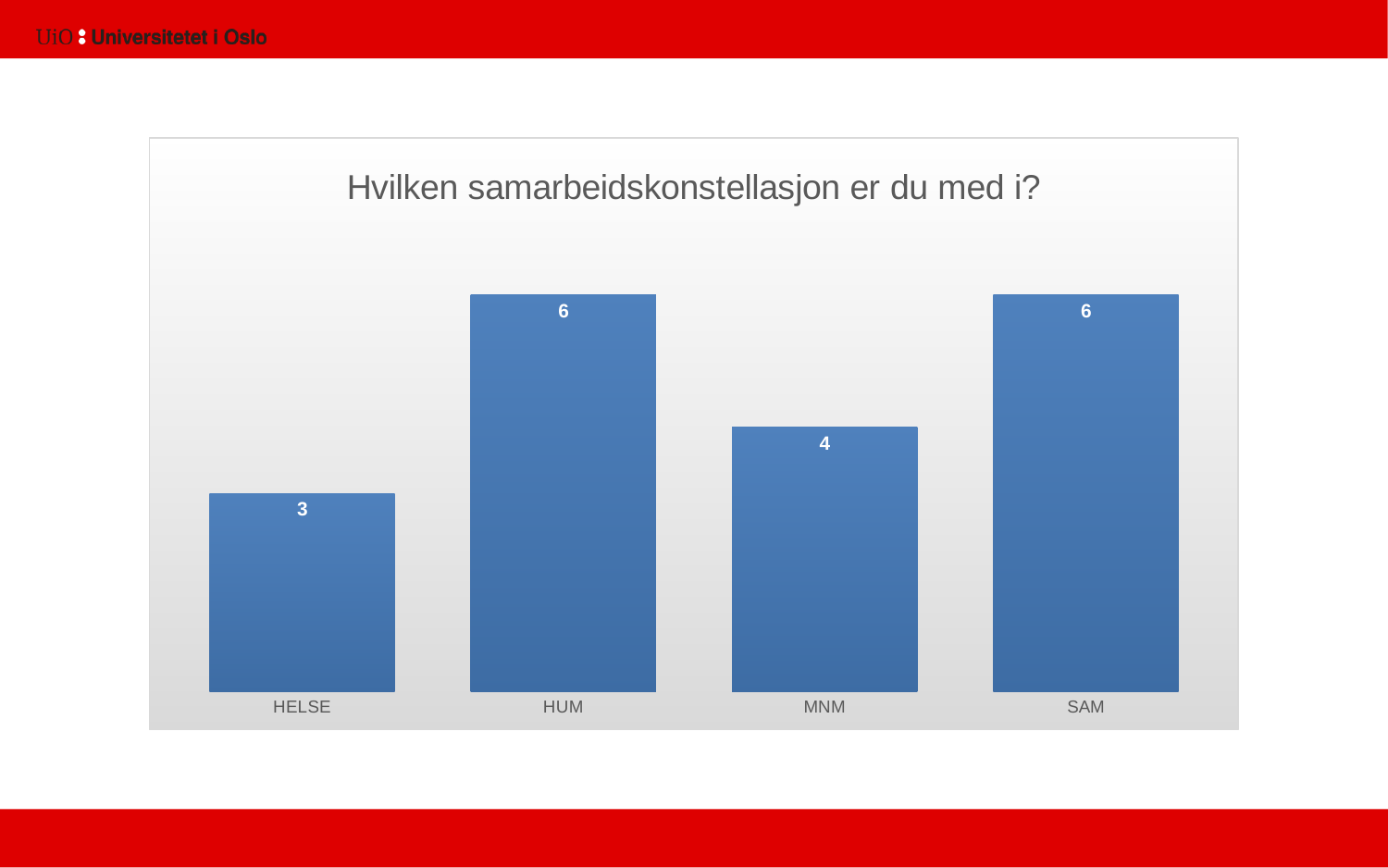
What is the value for HUM? 6 What kind of chart is shown on the slide? Bar chart How many categories are shown in the chart? 4 What is the value for SAM? 6 What is the value for HELSE? 3 What is the difference between the values for HUM and HELSE? 3 What is the difference between the values for MNM and HELSE? 1 What is the value for MNM? 4 Which category has the lowest value? HELSE What is the title of the chart? Hvilken samarbeidskonstellasjon er du med i? Which is larger, the value for MNM or the value for SAM? SAM Which is larger, the value for HELSE or the value for MNM? MNM